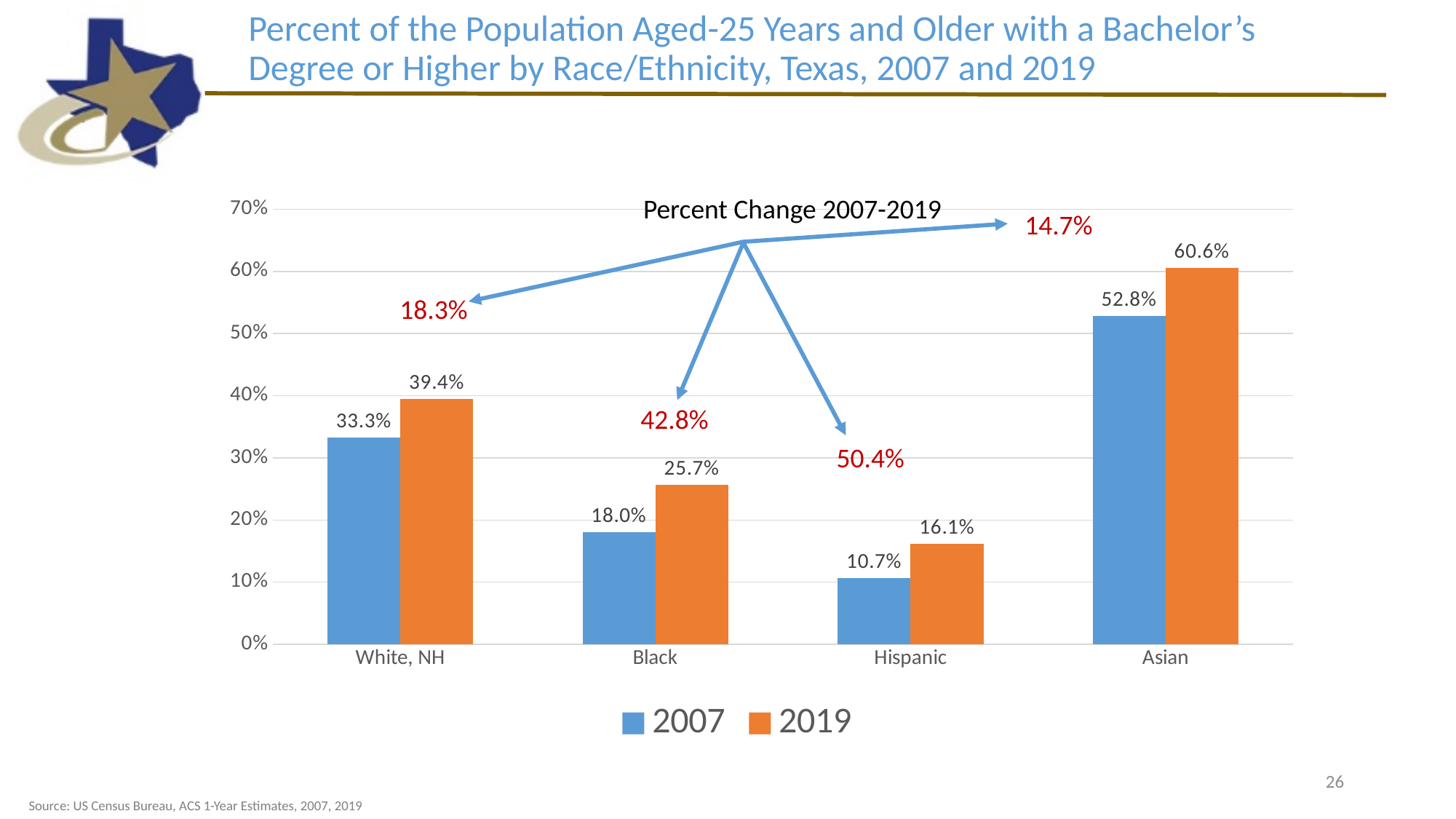
Which race/ethnicity group has the highest 2019 value? Asian What is the 2007 value for Hispanic? 10.7% What is the 2019 value for Asian? 60.6% Which colour represents the 2019 series in the legend? Orange Which race/ethnicity group has the lowest 2007 value? Hispanic How many race/ethnicity categories are shown on the x axis? 4 What is the difference between the 2019 and 2007 values for White, NH? 6.1% How many series does the legend list? 2 What kind of chart is shown on the slide? Bar chart Which is larger: the 2019 value for Black or the 2007 value for White, NH? 2007 value for White, NH What percent change from 2007 to 2019 is annotated for Hispanic? 50.4% What is the 2019 value for Black? 25.7%